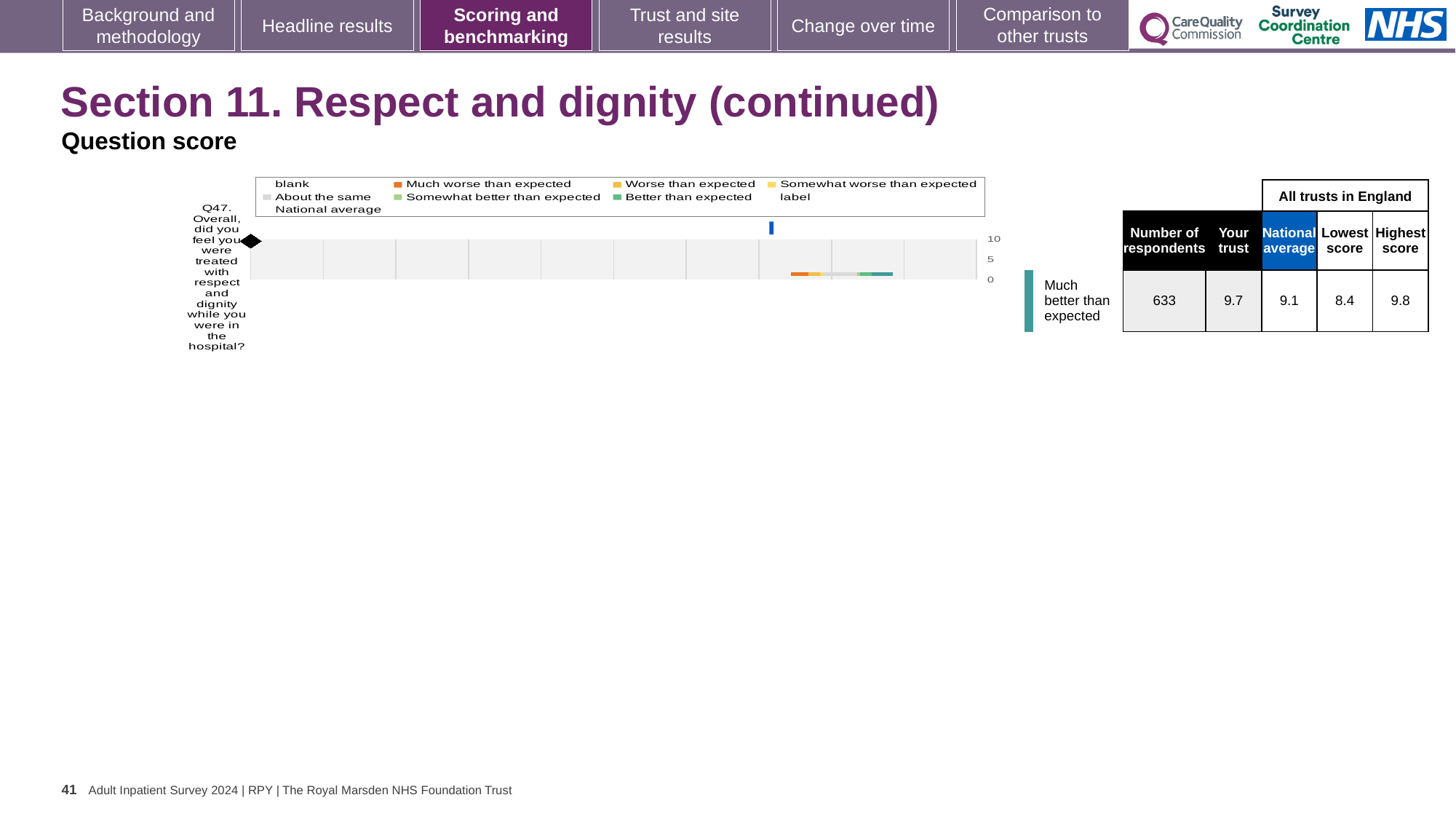
How many questions are plotted on the chart? 1 What is the maximum value shown on the chart's score axis? 10 What kind of chart is shown on the slide for Q47? bar chart What is the national average score for Q47? 9.1 Which benchmark category is the trust's Q47 score placed in? Much better than expected By how much does the trust's score for Q47 exceed the national average? 0.6 What is the highest score among all trusts in England for Q47? 9.8 What is the difference between the highest and lowest scores among all trusts in England for Q47? 1.4 What is the lowest score among all trusts in England for Q47? 8.4 What is the 'Your trust' score for Q47 (treated with respect and dignity)? 9.7 How many respondents answered Q47? 633 Which is higher for Q47: the trust's score or the national average? the trust's score